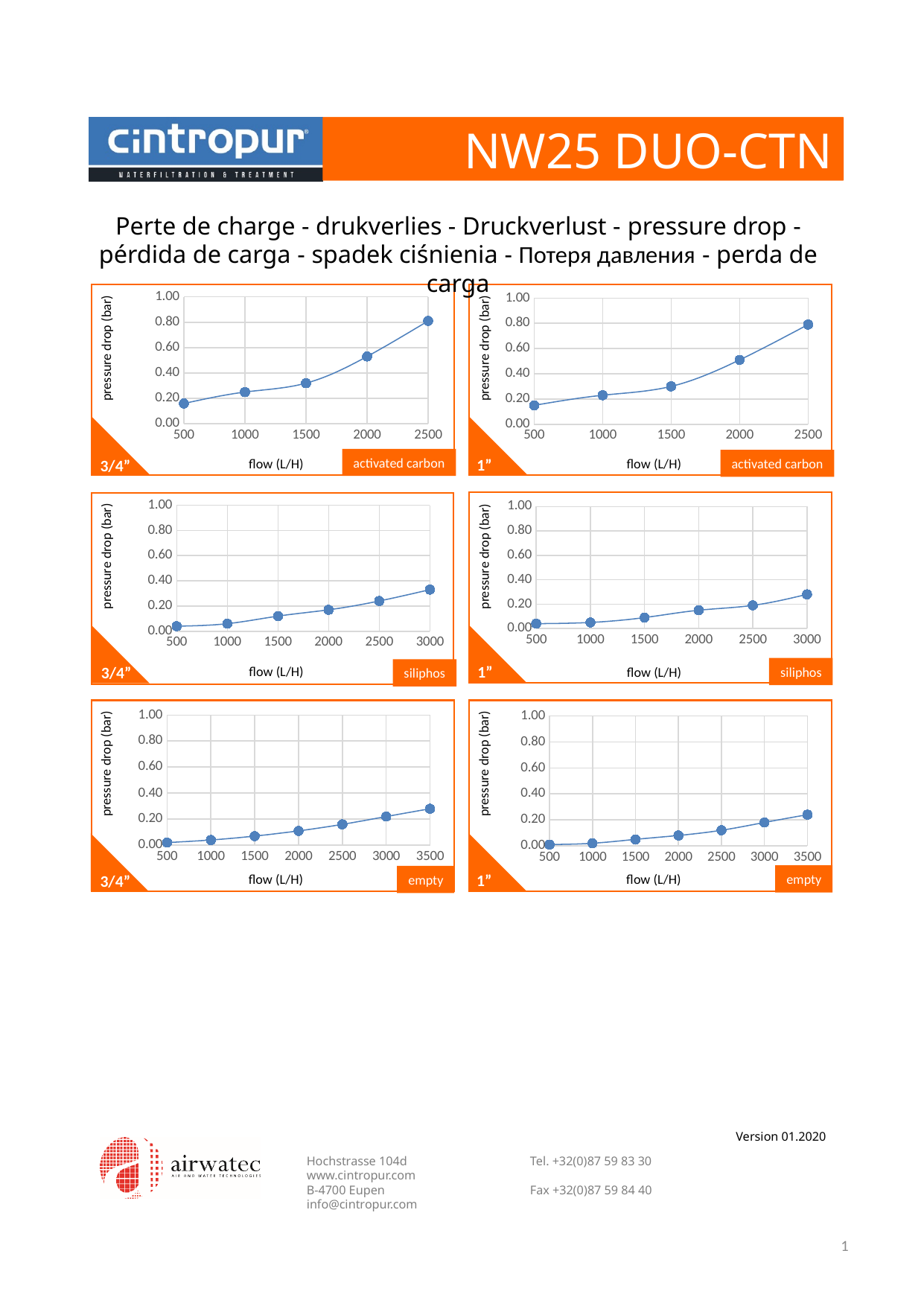
On the 1" empty chart (bottom right), is the pressure drop at a flow of 3500 greater or less than 0.40? less How many data points are plotted on the 1" siliphos chart (middle right)? 6 On the 3/4" activated carbon chart (top left), is the pressure drop at a flow of 500 greater or less than 0.20? less On the 1" activated carbon chart (top right), is the pressure drop at a flow of 2000 greater or less than 0.40? greater How many data points are plotted on the 3/4" empty chart (bottom left)? 7 What kind of chart is the 3/4" activated carbon chart (top left)? line chart How many data points are plotted on the 3/4" activated carbon chart (top left)? 5 What is the y-axis label on the 3/4" empty chart (bottom left)? pressure drop (bar) On the 1" activated carbon chart (top right), does the pressure drop rise or fall as flow increases? rises What is the x-axis label on the 1" siliphos chart (middle right)? flow (L/H)